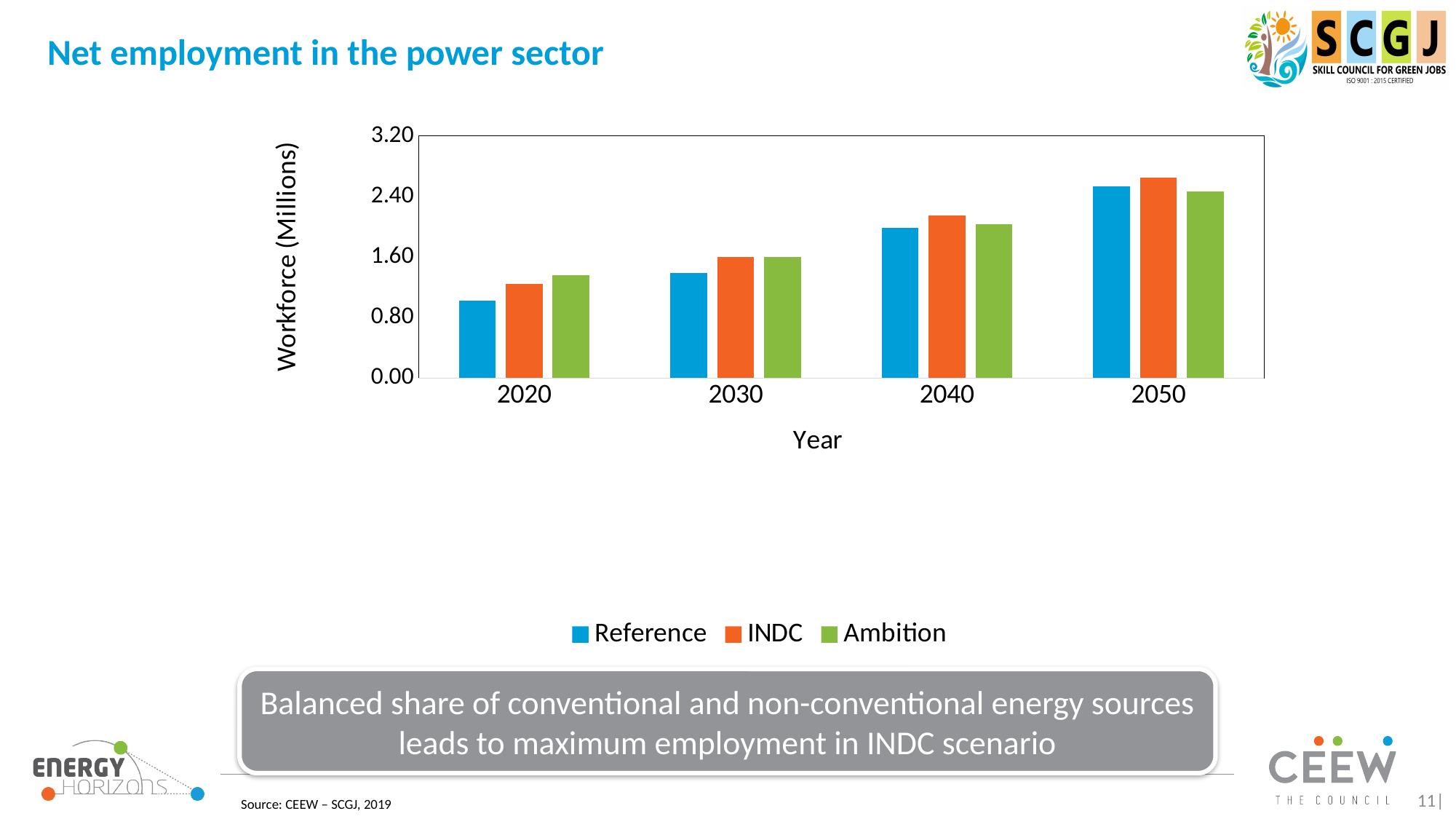
Is the INDC value for 2040 greater or less than 2.40? less Do the Reference values rise or fall from 2020 to 2050? rise Is the Reference value for 2040 greater or less than 1.60? greater In 2020, which is larger: the Reference value or the INDC value? INDC Is the Reference value for 2020 greater or less than 0.80? greater How many years are shown on the x axis? 4 Which series and year has the tallest bar in the chart? INDC in 2050 Which series and year has the shortest bar in the chart? Reference in 2020 What kind of chart is shown on the slide? bar chart How many series does the legend list? 3